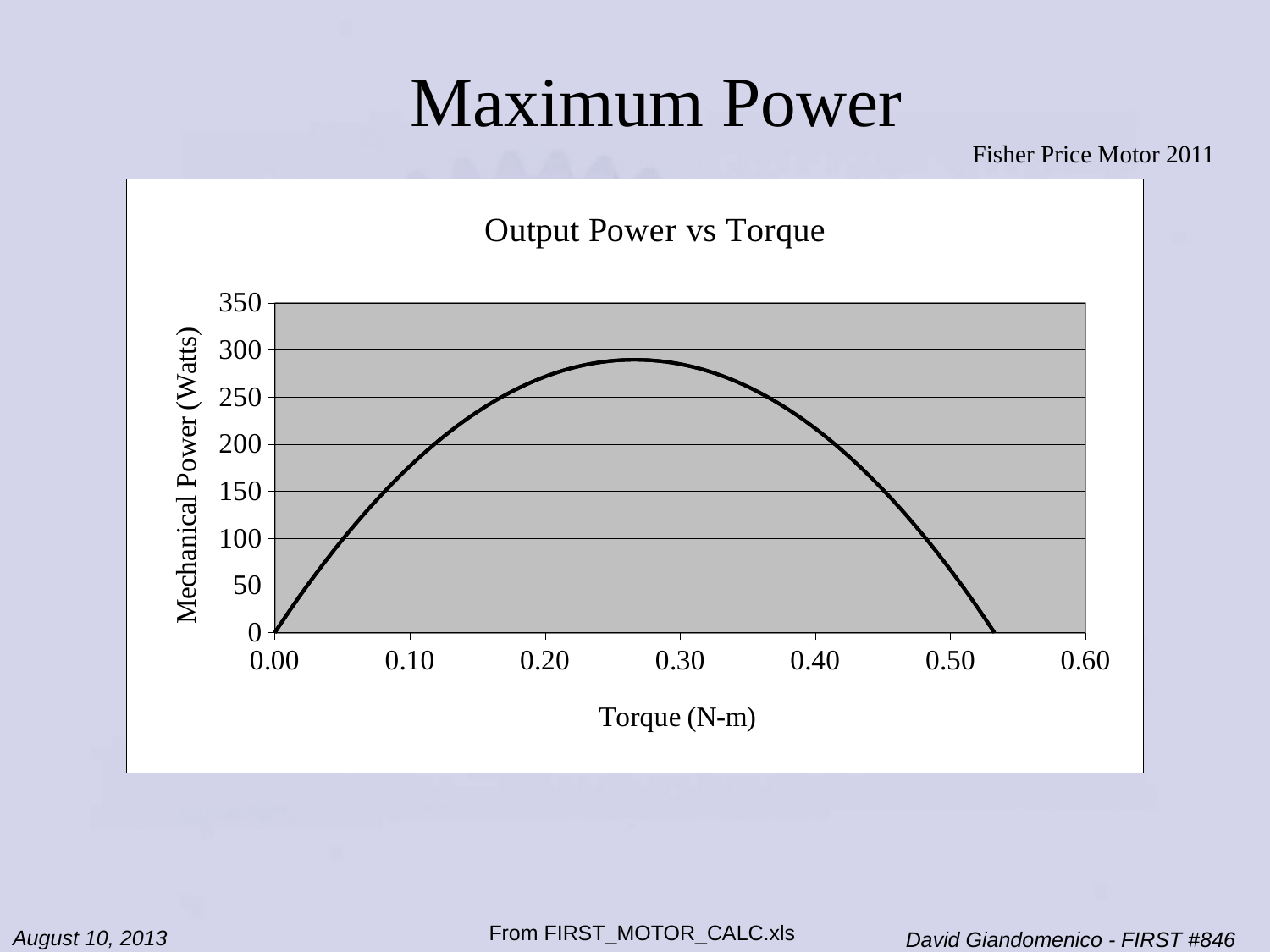
What kind of chart is shown on the slide? line chart Is the mechanical power at a torque of 0.10 N-m greater or less than 150? greater Which torque value has the higher mechanical power, 0.10 N-m or 0.50 N-m? 0.10 N-m Is the mechanical power at a torque of 0.50 N-m greater or less than 100? less How does mechanical power change as torque increases from 0.00 to 0.60 N-m? rises then falls What is the label of the vertical axis of the chart? Mechanical Power (Watts) Is the torque at which the mechanical power returns to zero greater or less than 0.50 N-m? greater What is the mechanical power at a torque of 0.00 N-m? 0 What is the title of the chart? Output Power vs Torque